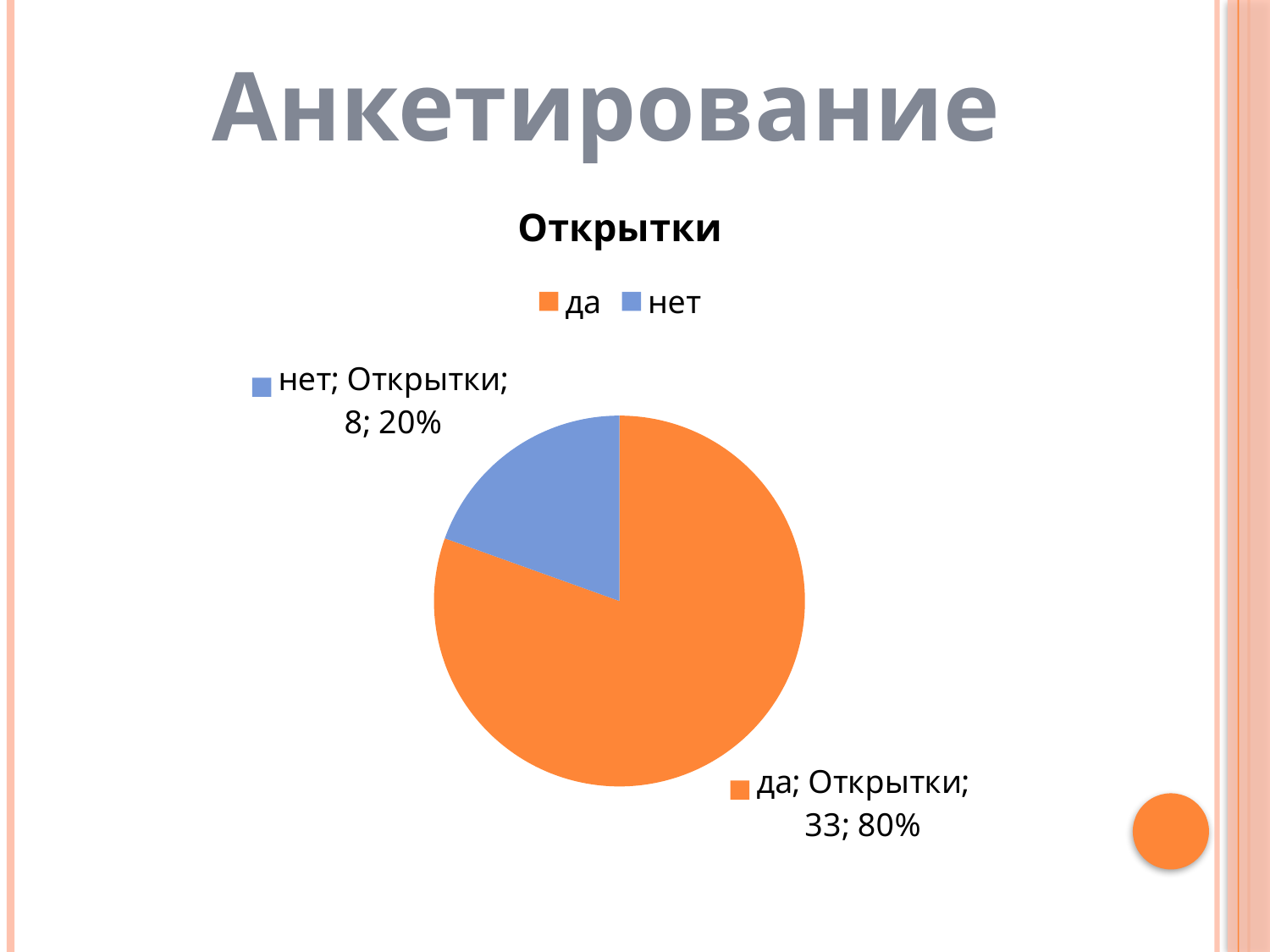
What is the title of the chart? Открытки What kind of chart is shown on the slide? pie chart Which category has the largest slice? да How many slices does the pie chart have? 2 How many entries does the legend list? 2 What is the difference between the values for "да" and "нет"? 25 What share of the pie does "нет" represent? 20% What is the value for "да"? 33 Which colour represents "нет" in the chart? blue Which category has the smallest slice? нет What share of the pie does "да" represent? 80% What is the value for "нет"? 8